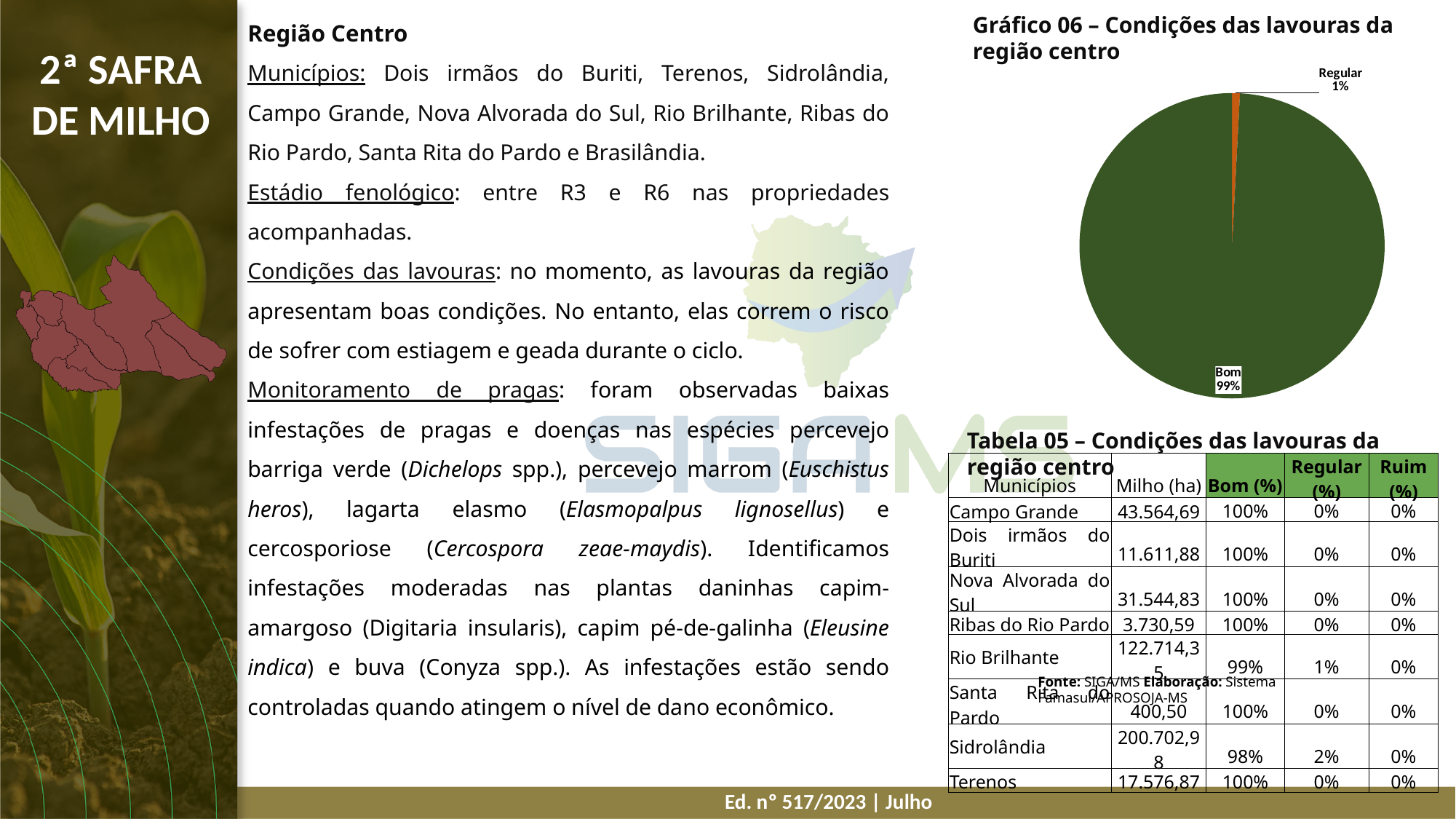
In Gráfico 06, what share of the pie is labelled Bom? 99% In Gráfico 06, what is the combined share of the Bom and Regular slices? 100% What kind of chart is Gráfico 06 – Condições das lavouras da região centro? pie chart In Gráfico 06, what is the difference between the Bom share and the Regular share? 98% In Gráfico 06, what share of the pie is labelled Regular? 1% In Gráfico 06, which is larger, the Bom slice or the Regular slice? Bom What is the title of the pie chart on the slide? Gráfico 06 – Condições das lavouras da região centro How many slices does the pie in Gráfico 06 have? 2 In Gráfico 06, what colour is the Bom slice? dark green In Gráfico 06, which slice is the largest? Bom In Gráfico 06, which slice is the smallest? Regular